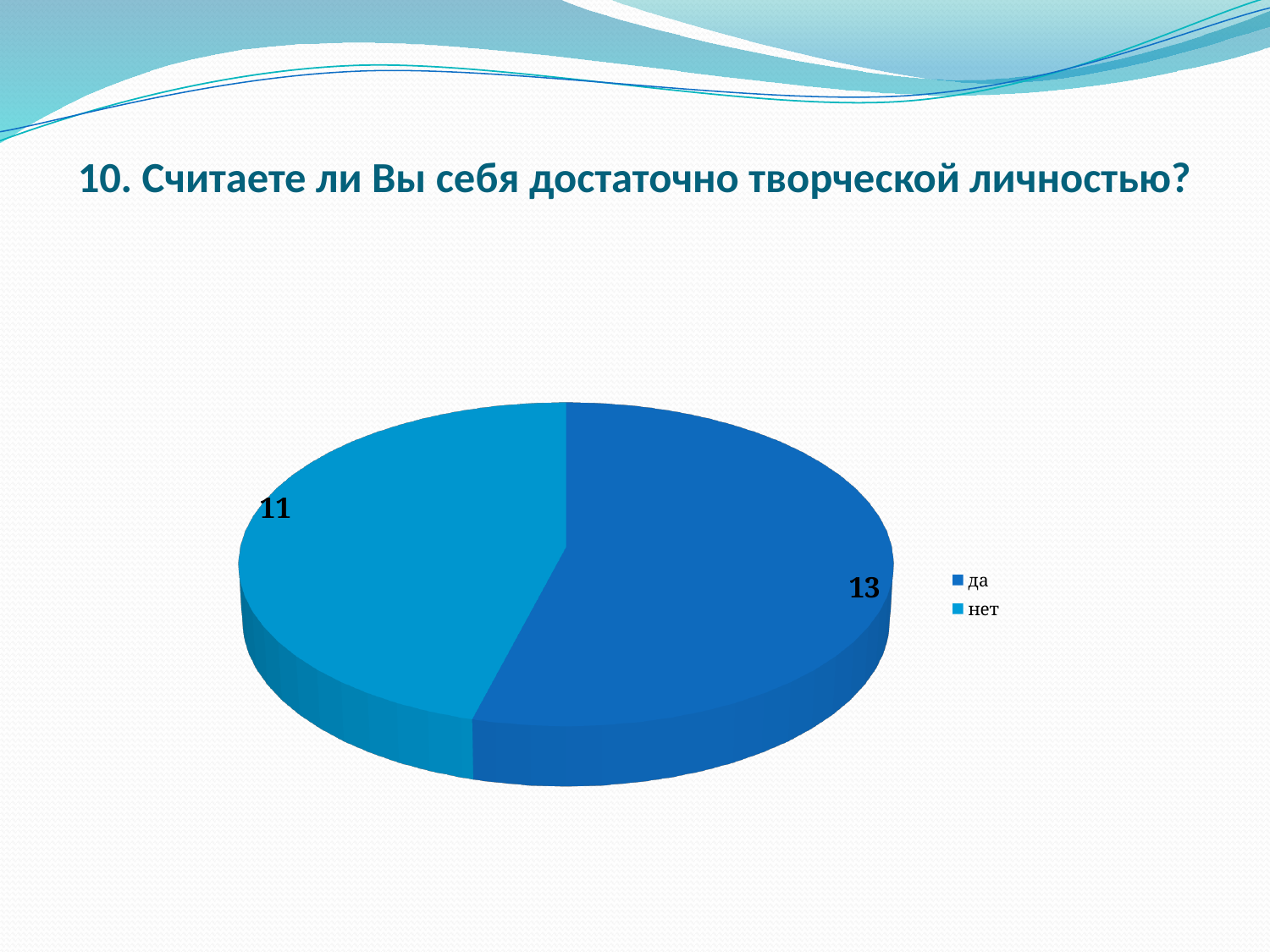
Which is larger, "да" or "нет"? да What value is shown for the "нет" slice? 11 What is the title of the slide above the chart? 10. Считаете ли Вы себя достаточно творческой личностью? What kind of chart is shown on the slide? pie chart How many slices does the pie chart have? 2 Which legend entry is shown in the darker blue colour? да What is the total of all slices in the pie chart? 24 What value is shown for the "да" slice? 13 Which slice is the largest? да What is the difference between the "да" and "нет" values? 2 Which slice is the smallest? нет How many entries does the legend list? 2